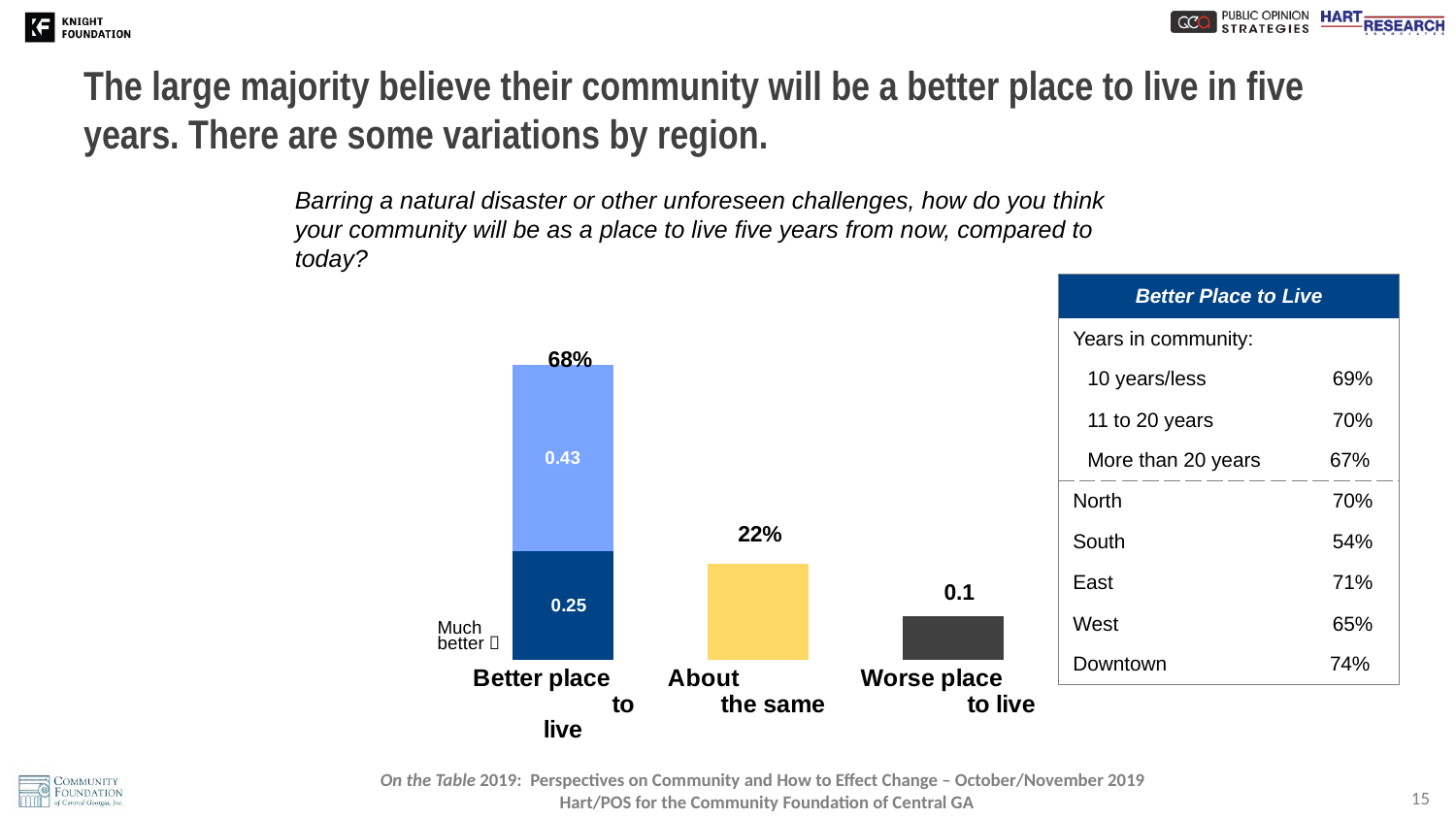
How many categories are shown on the x axis of the chart? 3 What total is printed above the "Better place to live" stacked bar? 68% What is the difference between the "Better place to live" total (68%) and the "About the same" value (22%)? 46 percentage points What value is printed on the upper, lighter blue segment of the "Better place to live" bar? 0.43 What is the value shown for the "About the same" bar? 22% What value is printed on the bottom ("Much better") segment of the "Better place to live" bar? 0.25 Which category has the tallest bar? Better place to live What value is printed above the "Worse place to live" bar? 0.1 Which is larger, the bar for "About the same" or the bar for "Worse place to live"? About the same Which category has the shortest bar? Worse place to live What kind of chart is shown on the slide? Bar chart What colour is the "About the same" bar? Yellow